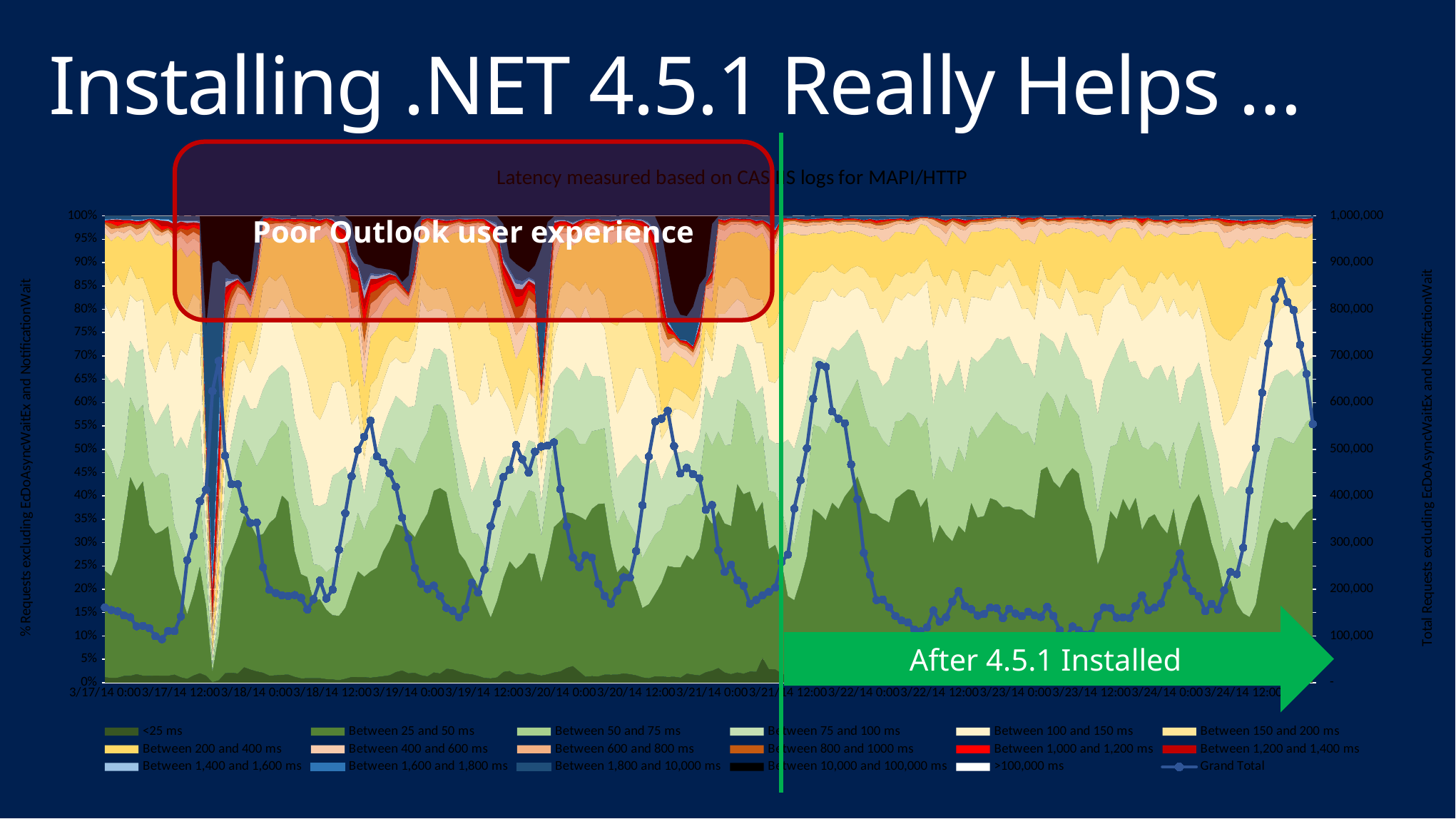
What kind of chart is shown on the slide? Stacked area chart with a line series Is the Grand Total value at 3/17/14 0:00 greater or less than 200,000? less Is the Grand Total value at 3/17/14 0:00 greater or less than 100,000? greater Which legend entry is plotted as a line with markers rather than an area? Grand Total What is the label of the left vertical axis? % Requests excluding EcDoAsyncWaitEx and NotificationWait What is the highest value shown on the right vertical axis? 1,000,000 Around which x-axis date does the Grand Total line reach its highest point? 3/24/14 12:00 Is the peak of the Grand Total line near 3/24/14 12:00 greater or less than 800,000? greater What is the title of the chart? Latency measured based on CAS IIS logs for MAPI/HTTP How many entries does the chart legend list? 18 What is the highest value shown on the left vertical axis? 100% Which is larger: the Grand Total peak near 3/24/14 12:00 or the Grand Total peak near 3/22/14 0:00? The peak near 3/24/14 12:00